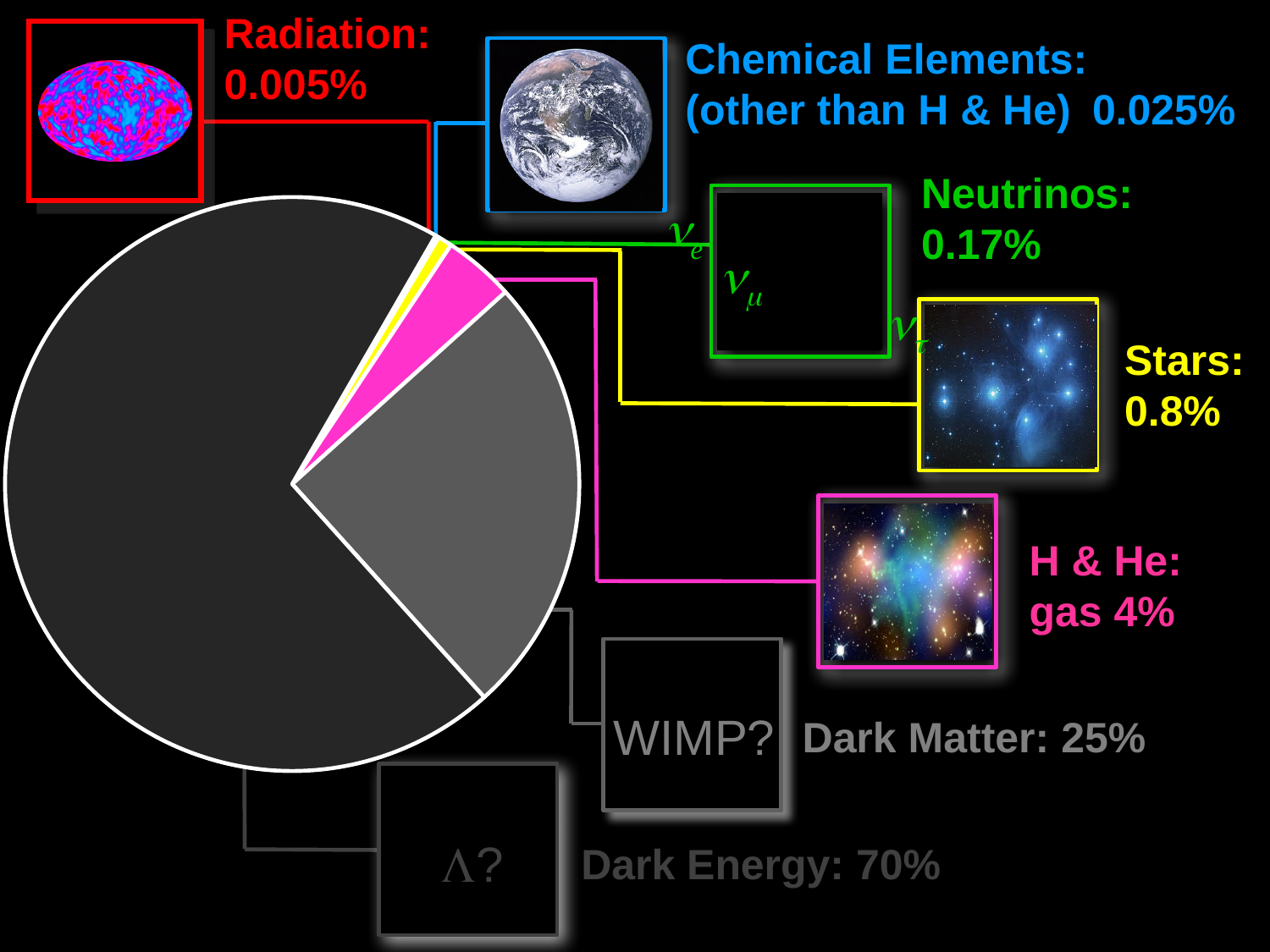
What is the difference between the Dark Energy and Dark Matter percentages? 45% What kind of chart is shown on the slide? pie chart What percentage is labelled for Radiation? 0.005% What percentage is labelled for H & He gas? 4% What percentage is labelled for Neutrinos? 0.17% What percentage is labelled for Stars? 0.8% Which is larger, the share for Stars or the share for H & He gas? H & He gas What percentage is labelled for Dark Matter? 25% Which component has the largest share of the pie? Dark Energy Which component has the smallest labelled percentage? Radiation What percentage is labelled for Dark Energy? 70% What percentage is labelled for Chemical Elements (other than H & He)? 0.025%